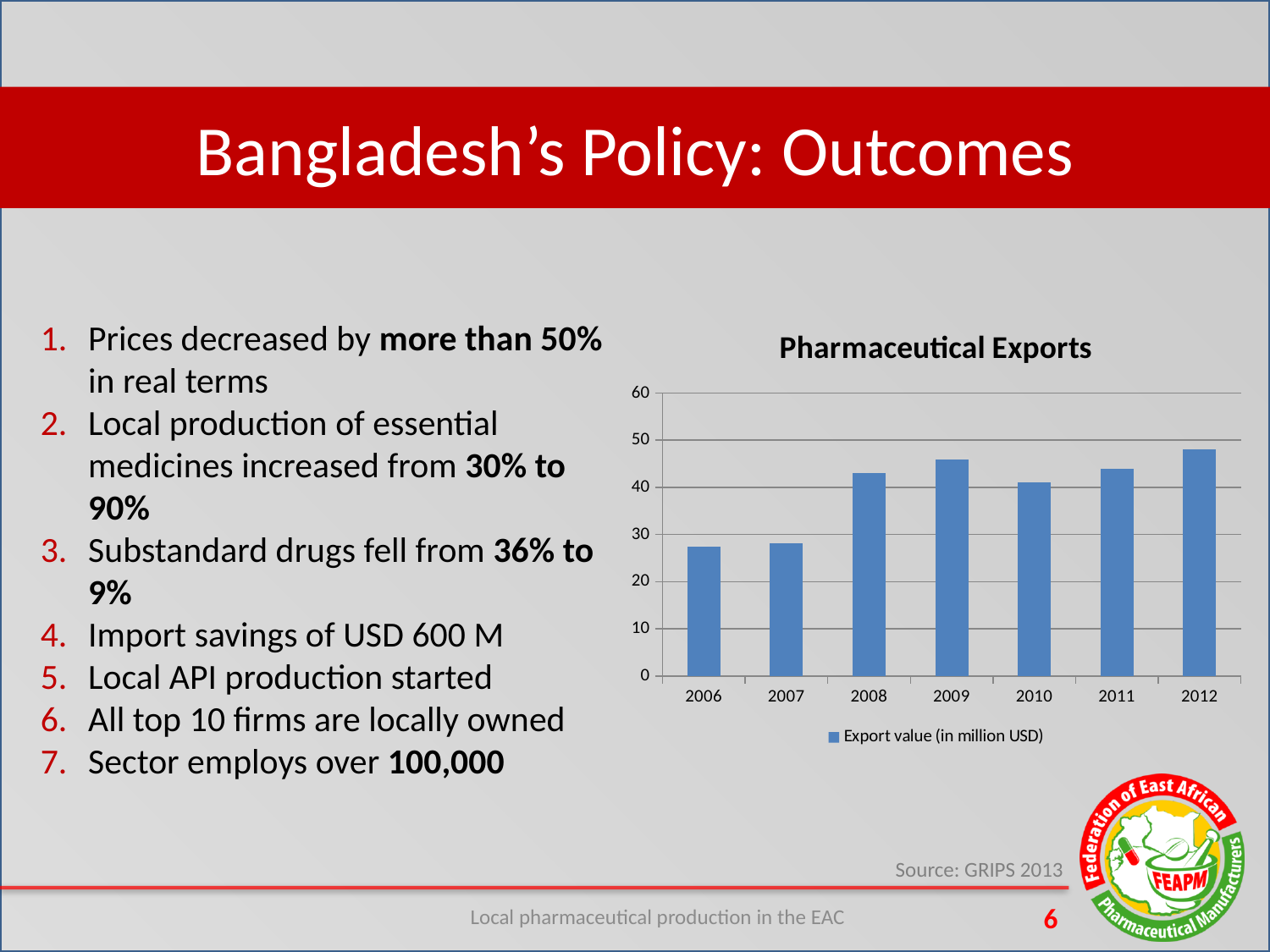
Is the export value for 2008 greater or less than 40? greater Is the export value for 2009 greater or less than 40? greater How many series does the legend of the Pharmaceutical Exports chart list? 1 Which year has the highest export value in the Pharmaceutical Exports chart? 2012 Which year has the larger export value, 2009 or 2010? 2009 What is the source cited for the Pharmaceutical Exports chart? GRIPS 2013 How many years are plotted in the Pharmaceutical Exports chart? 7 Which year has the larger export value, 2006 or 2008? 2008 What type of chart is shown under the title "Pharmaceutical Exports"? bar chart What is the legend entry in the Pharmaceutical Exports chart? Export value (in million USD) Is the export value for 2012 greater or less than 50? less